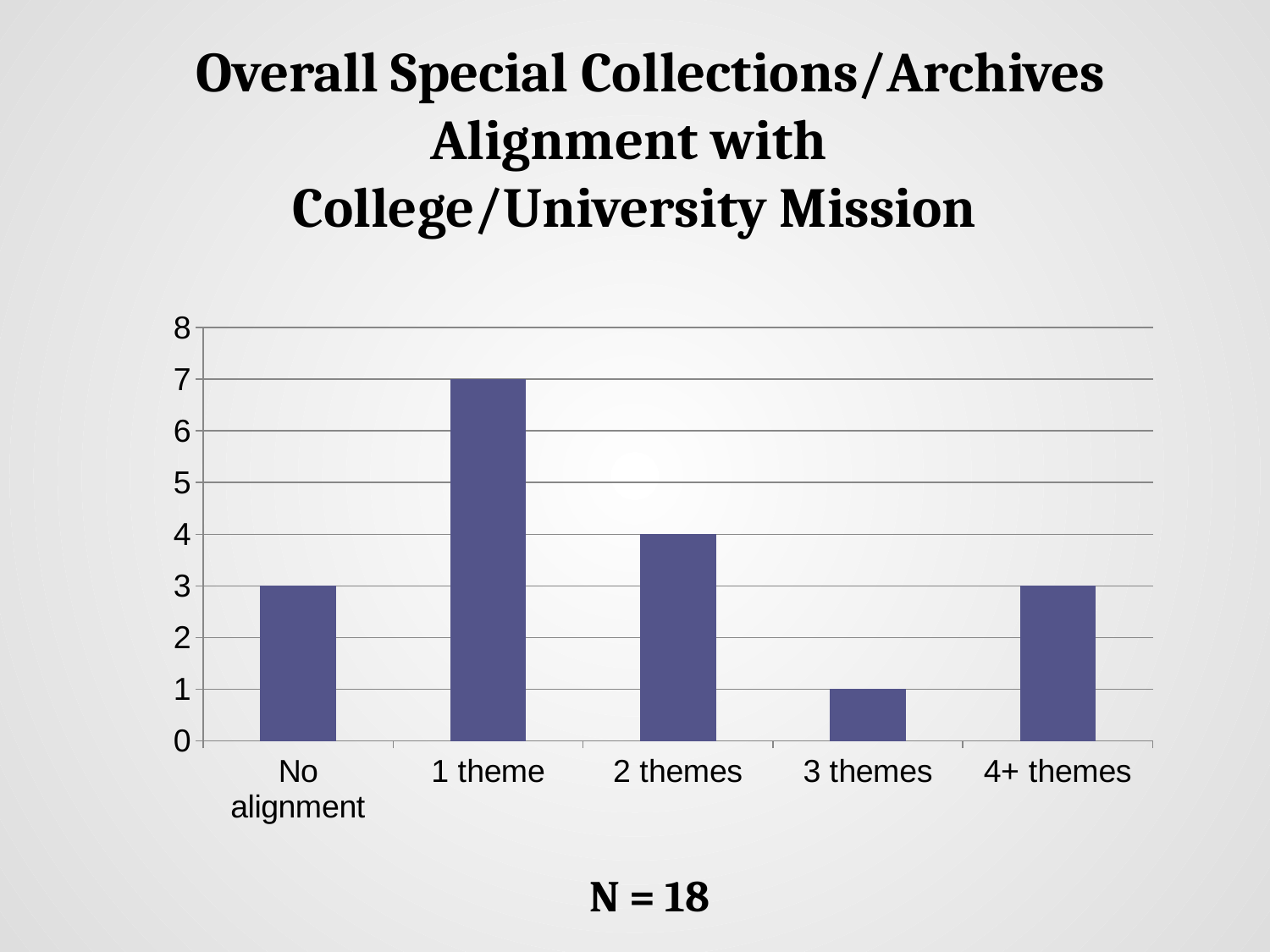
Which is larger, the value for 2 themes or the value for 4+ themes? 2 themes What kind of chart is shown on the slide? bar chart What is the difference between the values for 1 theme and 2 themes? 3 Which category has the highest value? 1 theme What is the value for 1 theme? 7 Which category has the lowest value? 3 themes What is the value for 3 themes? 1 What sample size (N) is stated below the chart? N = 18 What is the value for 2 themes? 4 What is the value for No alignment? 3 Is the value for 1 theme greater or less than 5? greater How many categories are shown on the x axis? 5